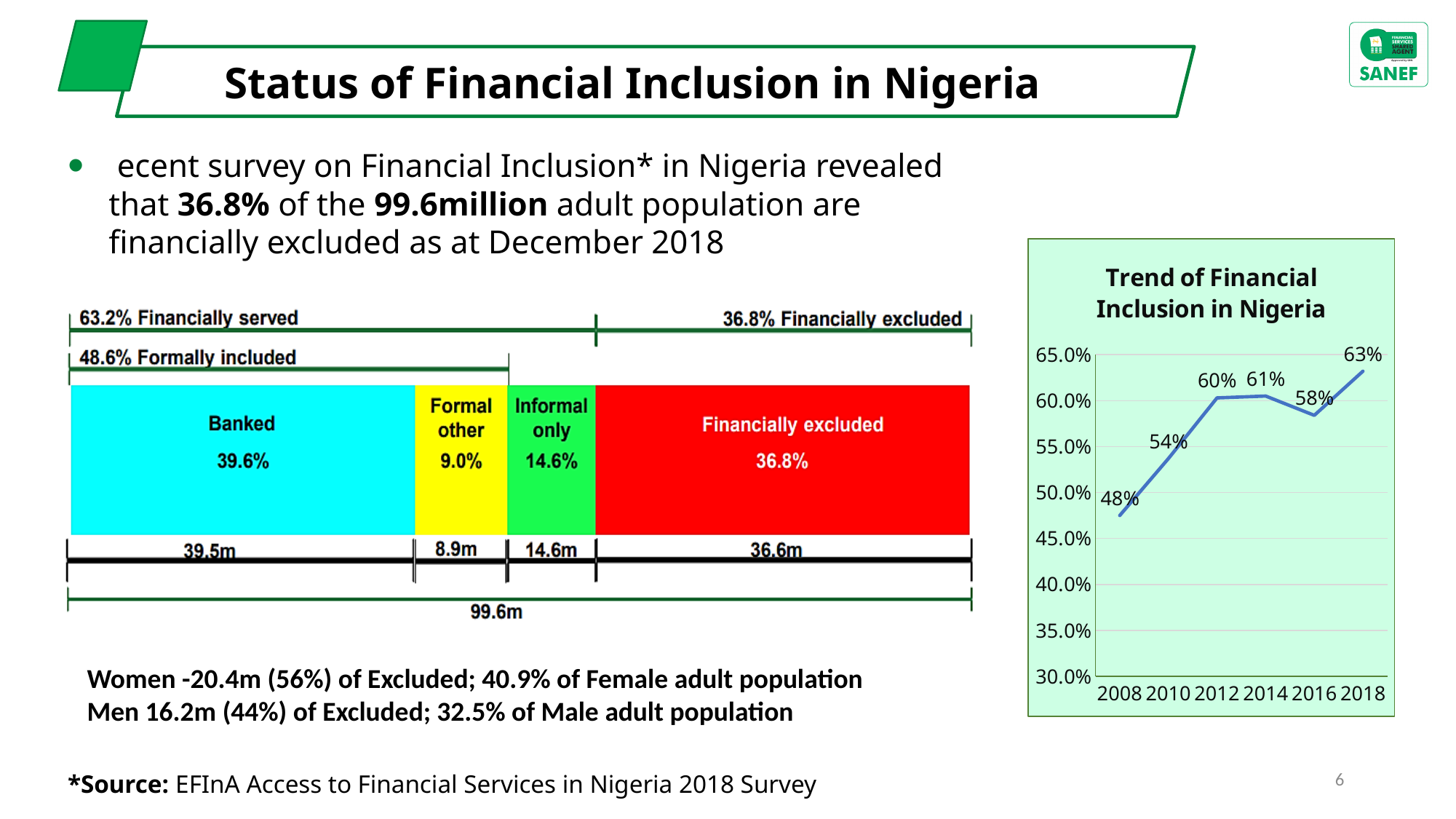
In the 'Trend of Financial Inclusion in Nigeria' chart, which year has the lowest value? 2008 In the access strand bar on the left of the slide, what is the total adult population shown beneath the bar? 99.6m In the 'Trend of Financial Inclusion in Nigeria' chart, which year has the highest value? 2018 In the 'Trend of Financial Inclusion in Nigeria' chart, do the values generally rise or fall from 2008 to 2018? Rise In the 'Trend of Financial Inclusion in Nigeria' chart, what is the value for 2008? 48% What kind of chart is the 'Trend of Financial Inclusion in Nigeria' chart? Line chart In the 'Trend of Financial Inclusion in Nigeria' chart, is the value for 2010 greater or less than 50.0%? greater In the access strand bar on the left of the slide, what percentage is labelled 'Banked'? 39.6% In the 'Trend of Financial Inclusion in Nigeria' chart, which year has the larger value, 2014 or 2016? 2014 In the 'Trend of Financial Inclusion in Nigeria' chart, by how many percentage points did the value increase from 2008 to 2018? 15 percentage points How many years are plotted in the 'Trend of Financial Inclusion in Nigeria' chart? 6 In the 'Trend of Financial Inclusion in Nigeria' chart, what is the value for 2016? 58%